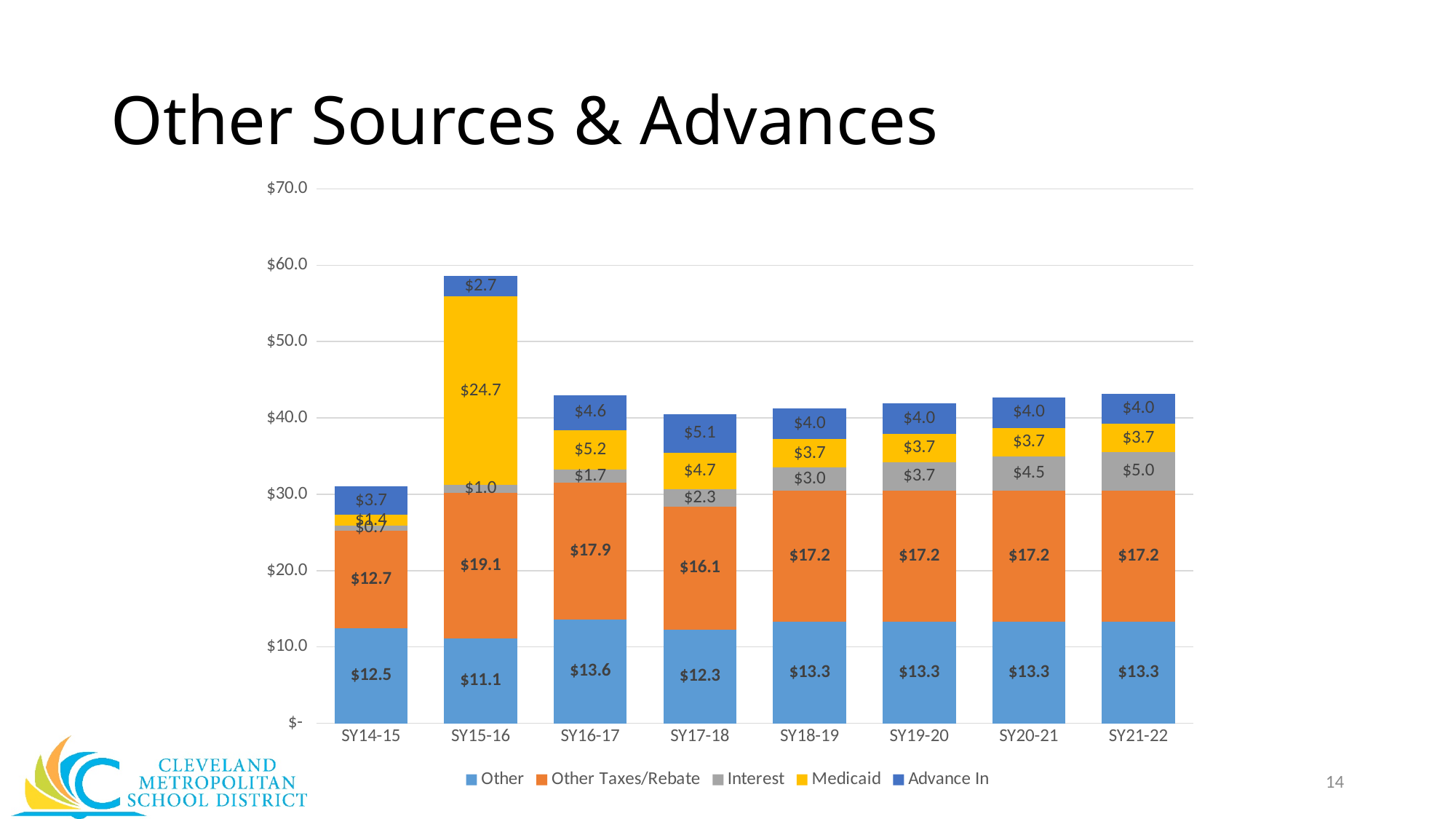
How many school years are shown on the x axis? 8 Which school year has the lowest value for the Other series? SY15-16 Which is larger, the Advance In value for SY17-18 or for SY16-17? SY17-18 What is the Interest value for SY21-22? $5.0 What is the Other Taxes/Rebate value for SY16-17? $17.9 What is the difference between the Other Taxes/Rebate values for SY15-16 and SY14-15? $6.4 Is the total height of the SY15-16 stacked bar greater or less than $50.0? greater What is the total of the SY16-17 stacked bar? $43.0 Which school year has the highest Medicaid value? SY15-16 What kind of chart is shown on the slide? Stacked bar chart How many series does the legend list? 5 What is the Medicaid value for SY15-16? $24.7